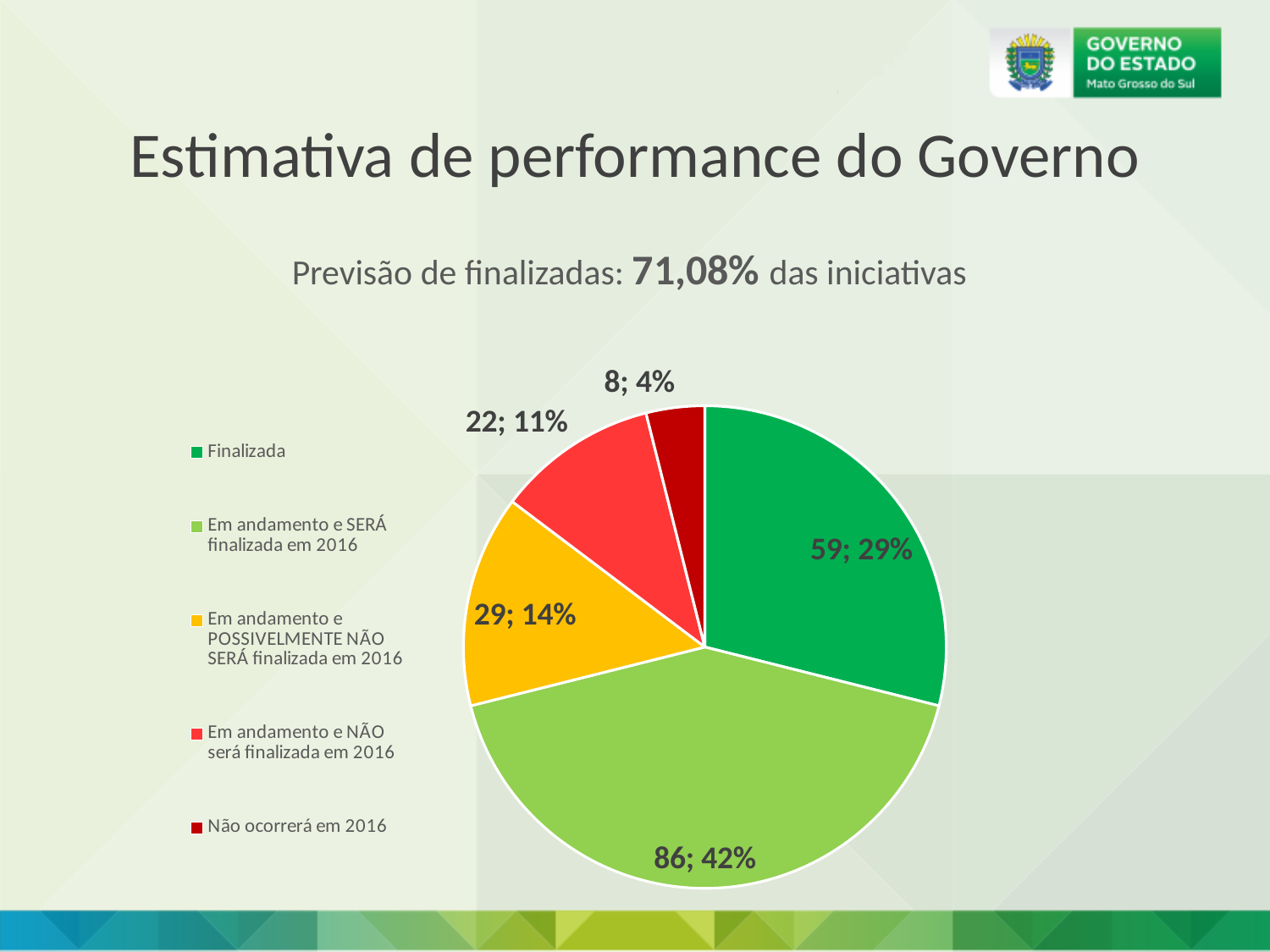
What is the value shown for the 'Finalizada' slice? 59 What percentage share does the 'Em andamento e SERÁ finalizada em 2016' slice have? 42% What is the difference between the values for 'Em andamento e SERÁ finalizada em 2016' and 'Finalizada'? 27 What is the value shown for 'Em andamento e POSSIVELMENTE NÃO SERÁ finalizada em 2016'? 29 What type of chart is shown on the slide? pie chart Which category has the smallest slice of the pie? Não ocorrerá em 2016 How many slices does the pie chart have? 5 What percentage share does the 'Não ocorrerá em 2016' slice have? 4% Which category has the largest slice of the pie? Em andamento e SERÁ finalizada em 2016 Which is larger: the value for 'Em andamento e NÃO será finalizada em 2016' or for 'Em andamento e POSSIVELMENTE NÃO SERÁ finalizada em 2016'? Em andamento e POSSIVELMENTE NÃO SERÁ finalizada em 2016 How many entries does the legend list? 5 What colour is the 'Finalizada' slice in the pie chart? dark green